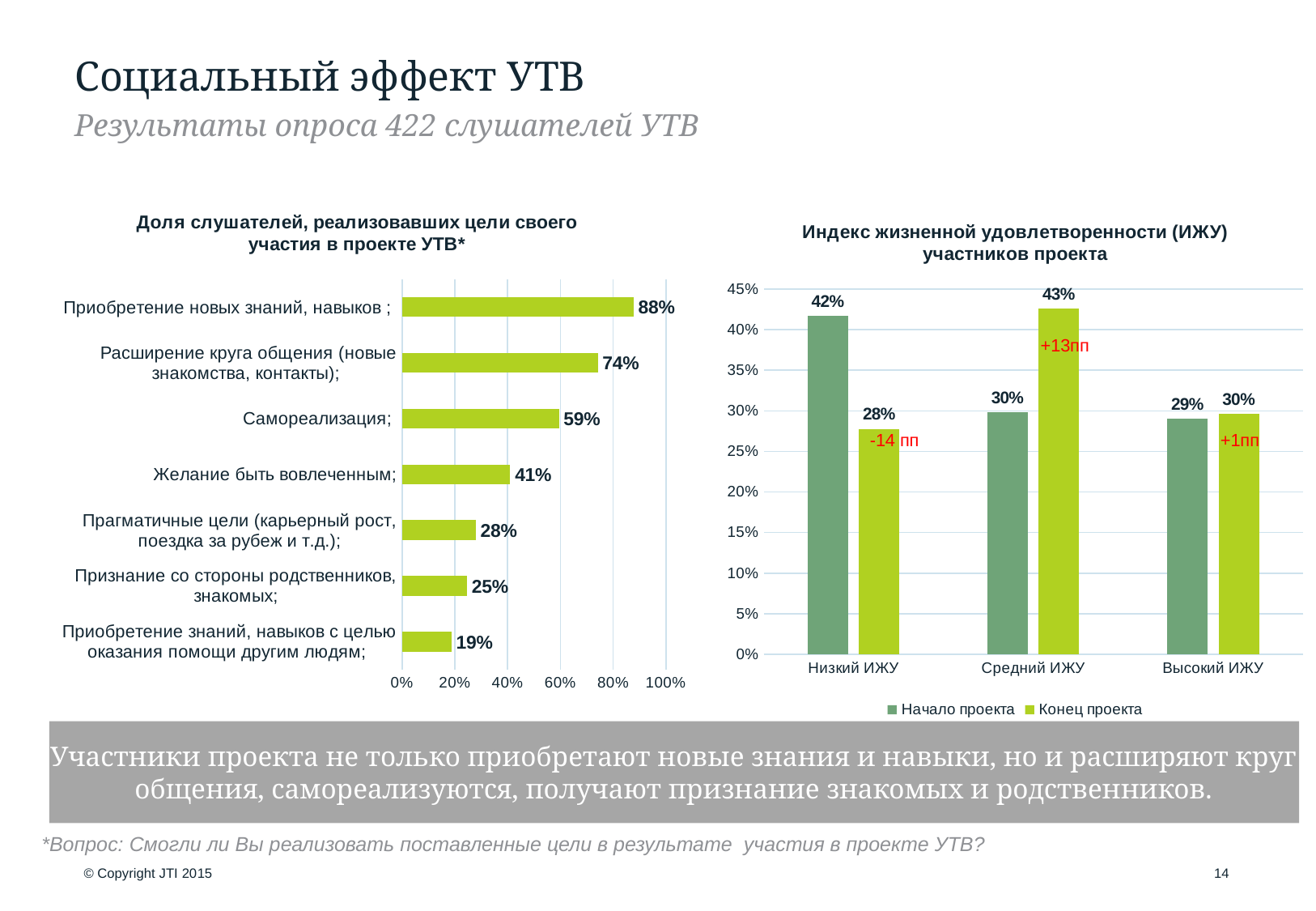
In the right chart 'Индекс жизненной удовлетворенности (ИЖУ) участников проекта', what is the value for 'Начало проекта' in the 'Низкий ИЖУ' group? 42% In the left chart 'Доля слушателей, реализовавших цели своего участия в проекте УТВ*', which category has the lowest value? Приобретение знаний, навыков с целью оказания помощи другим людям In the right chart 'Индекс жизненной удовлетворенности (ИЖУ) участников проекта', what is the value for 'Конец проекта' in the 'Средний ИЖУ' group? 43% What kind of chart is the left chart 'Доля слушателей, реализовавших цели своего участия в проекте УТВ*'? Bar chart In the left chart 'Доля слушателей, реализовавших цели своего участия в проекте УТВ*', what is the value for 'Самореализация'? 59% In the left chart 'Доля слушателей, реализовавших цели своего участия в проекте УТВ*', how many categories are shown? 7 In the left chart 'Доля слушателей, реализовавших цели своего участия в проекте УТВ*', which category has the highest value? Приобретение новых знаний, навыков In the right chart 'Индекс жизненной удовлетворенности (ИЖУ) участников проекта', what is the difference between 'Начало проекта' and 'Конец проекта' for 'Низкий ИЖУ'? 14% In the left chart 'Доля слушателей, реализовавших цели своего участия в проекте УТВ*', what is the difference between 'Приобретение новых знаний, навыков' and 'Расширение круга общения (новые знакомства, контакты)'? 14% In the right chart 'Индекс жизненной удовлетворенности (ИЖУ) участников проекта', which is larger for 'Низкий ИЖУ': 'Начало проекта' or 'Конец проекта'? Начало проекта In the right chart 'Индекс жизненной удовлетворенности (ИЖУ) участников проекта', what are the two legend entries? Начало проекта, Конец проекта How many series does the legend of the right chart 'Индекс жизненной удовлетворенности (ИЖУ) участников проекта' list? 2